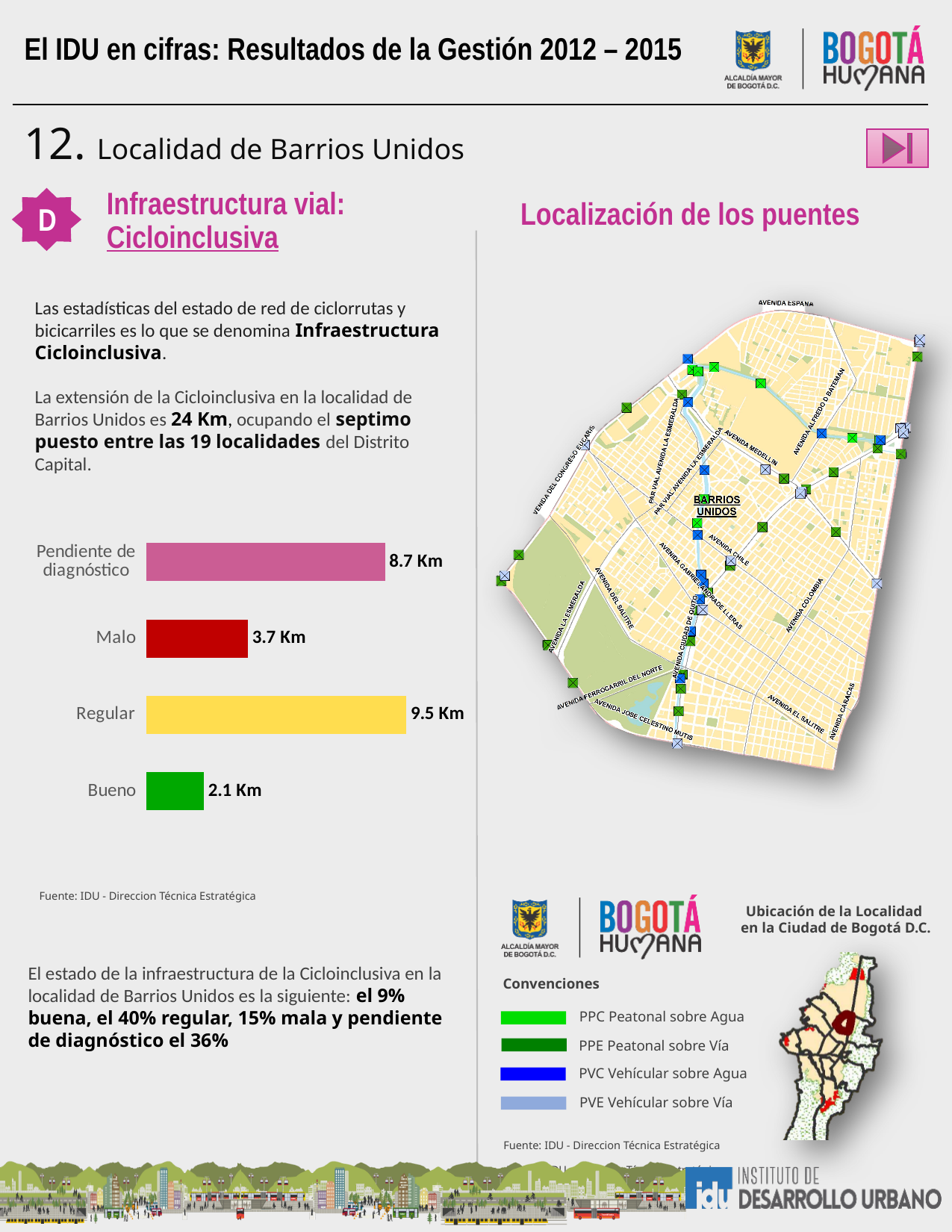
What kind of chart is shown on the left of the slide? Bar chart Which category has the highest value in the bar chart? Regular What is the value for Bueno in the bar chart? 2.1 Km What colour is the bar for Regular? Yellow What is the difference between the values for Malo and Bueno? 1.6 Km What is the difference between the values for Regular and Pendiente de diagnóstico? 0.8 Km What is the value for Regular in the bar chart? 9.5 Km Which category has the lowest value in the bar chart? Bueno What is the value for Malo in the bar chart? 3.7 Km What is the value for Pendiente de diagnóstico in the bar chart? 8.7 Km How many categories are shown in the bar chart? 4 Which is larger, the value for Malo or the value for Bueno? Malo